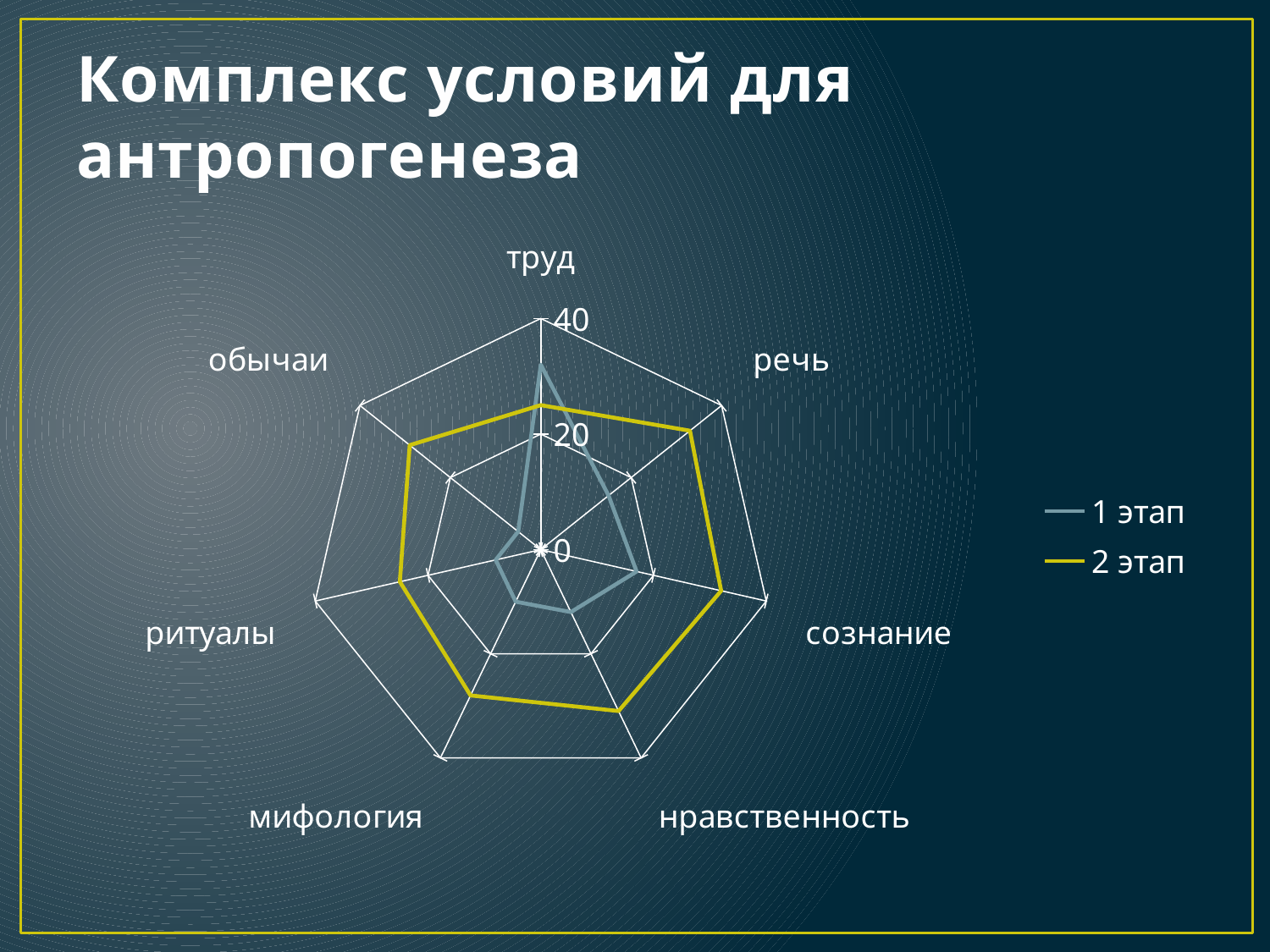
Is the value for сознание in the series 2 этап greater or less than 20? greater For the category труд, which series has the larger value, 1 этап or 2 этап? 1 этап How many categories (axes) does the radar chart have? 7 For the category речь, which series has the larger value, 1 этап or 2 этап? 2 этап What is the title of the slide containing the chart? Комплекс условий для антропогенеза Is the value for мифология in the series 2 этап greater or less than 40? less Which category has the highest value for the series 1 этап? труд Is the value for труд in the series 1 этап greater or less than 20? greater What kind of chart is shown on the slide? radar chart How many series does the legend list? 2